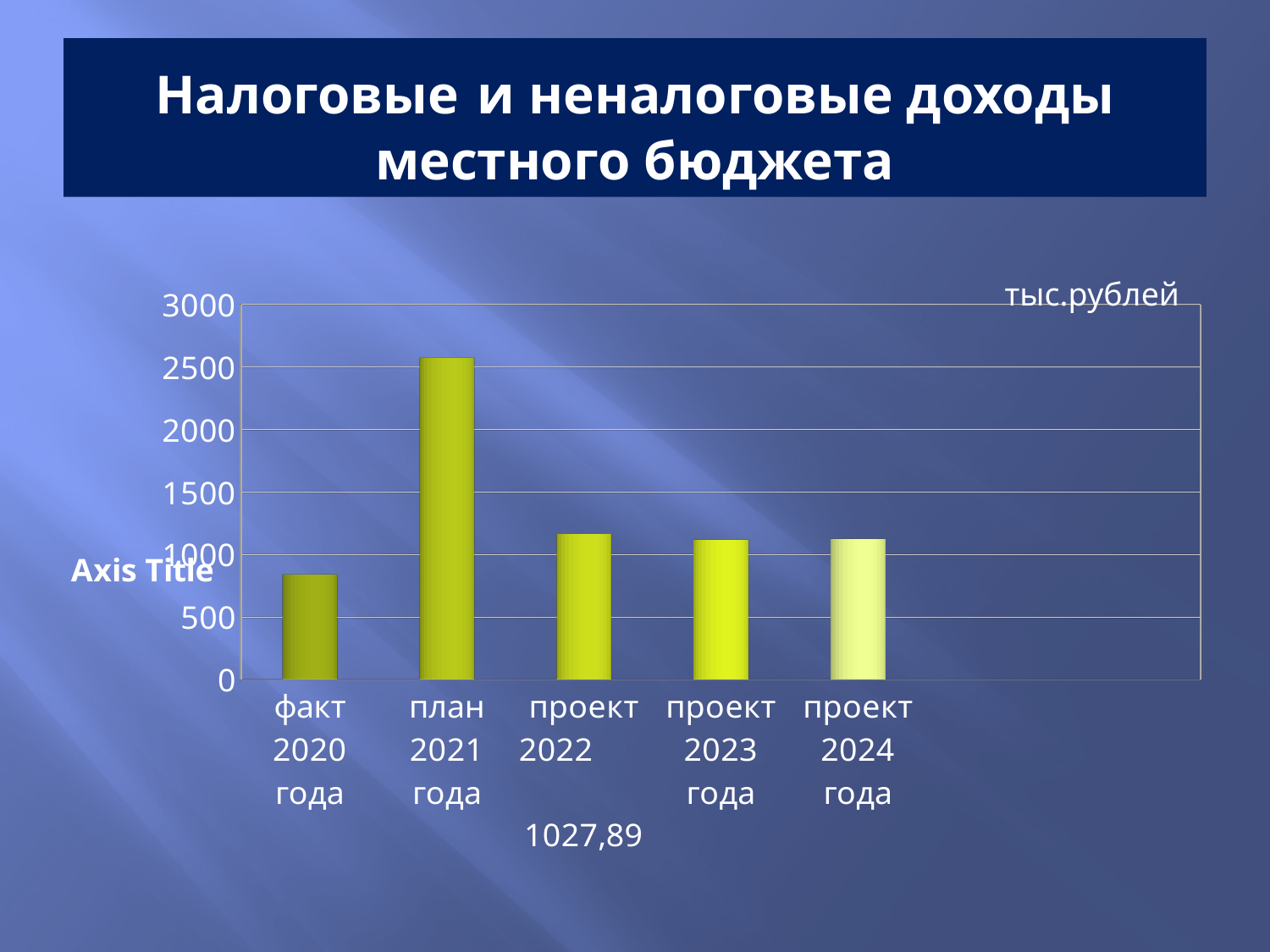
Is the value for проект 2022 greater or less than 1000? greater What is the title of the slide? Налоговые и неналоговые доходы местного бюджета Is the value for план 2021 года greater or less than 2500? greater Which is larger, the value for факт 2020 года or the value for проект 2023 года? проект 2023 года How many bars (categories) are plotted in the chart? 5 Is the value for факт 2020 года greater or less than 1000? less What kind of chart is shown on the slide? bar chart What unit is indicated in the top right corner of the chart? тыс.рублей Which category has the highest bar in the chart? план 2021 года Which is larger, the value for план 2021 года or the value for проект 2022? план 2021 года Which category has the lowest bar in the chart? факт 2020 года